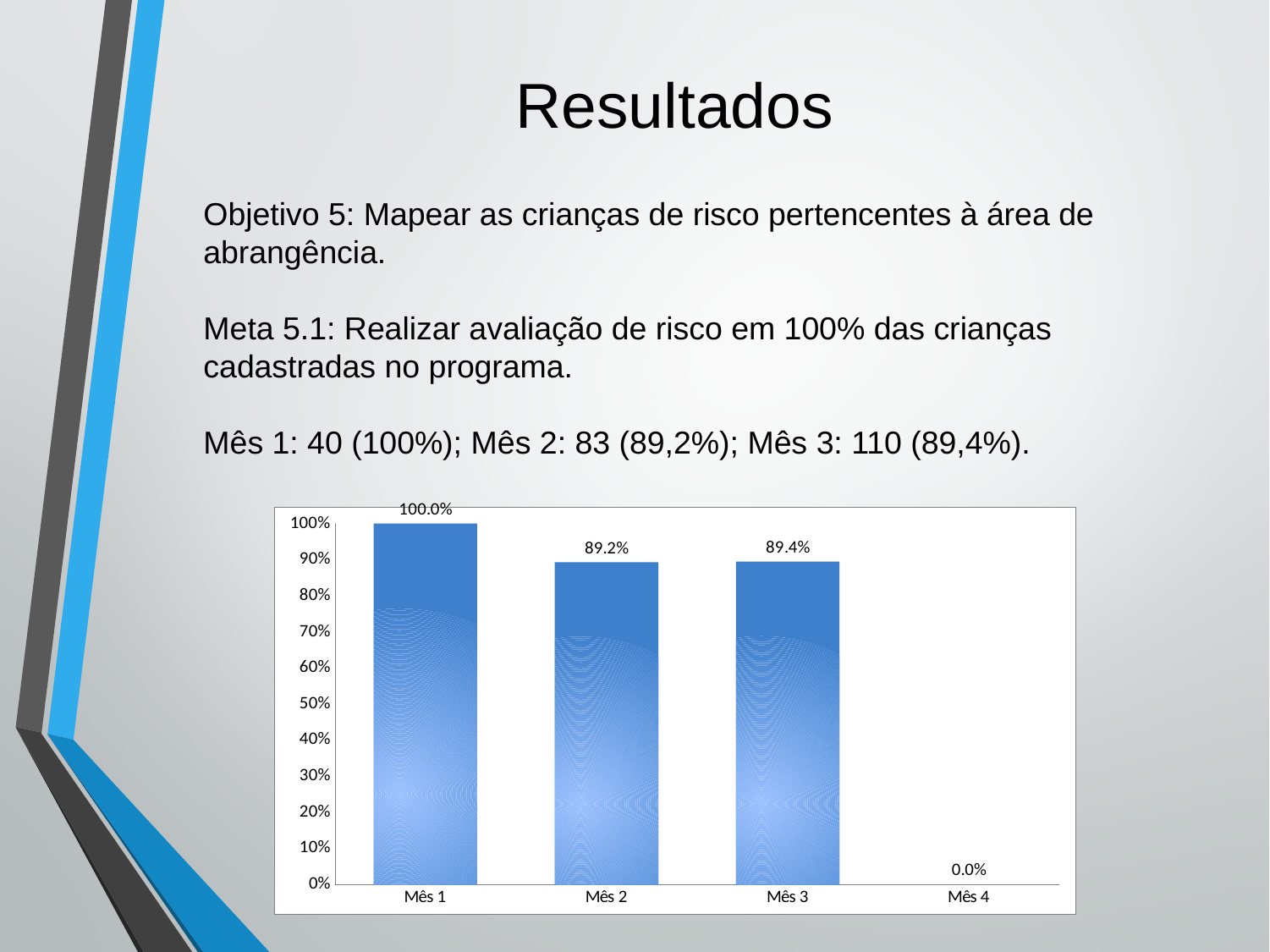
What is the value for Mês 3? 89.4% How many categories are shown on the x axis? 4 What is the difference between the values for Mês 1 and Mês 2? 10.8% What is the value for Mês 2? 89.2% Is the value for Mês 2 greater or less than 90%? less What is the difference between the values for Mês 3 and Mês 2? 0.2% What is the value for Mês 4? 0.0% Which is larger, the value for Mês 1 or the value for Mês 3? Mês 1 Which category has the lowest value? Mês 4 What kind of chart is shown on the slide? Bar chart What is the value for Mês 1? 100.0% Which category has the highest value? Mês 1